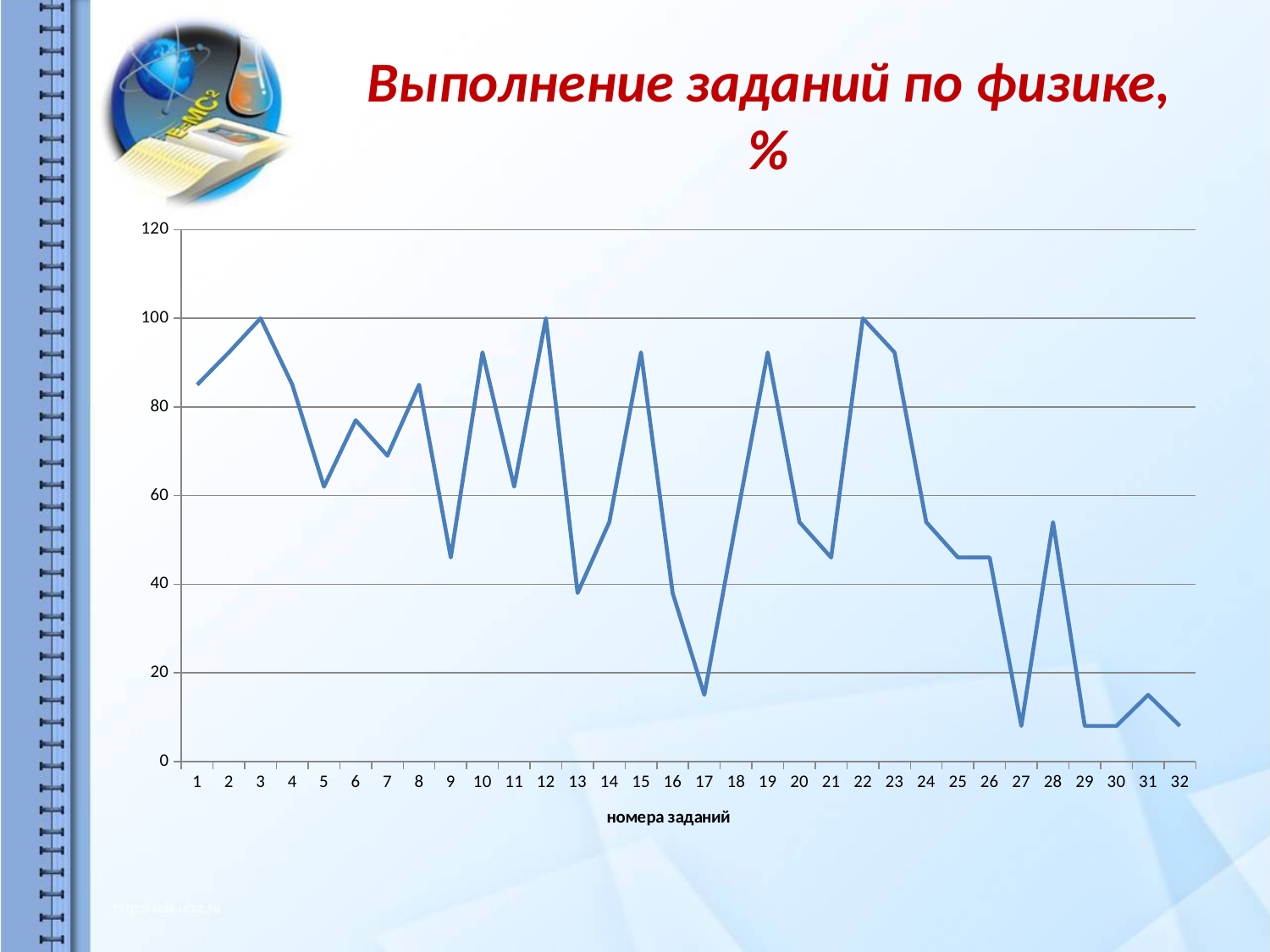
What is the value for task 12? 100 What is the label of the x axis? номера заданий What is the value for task 3? 100 Overall, do the values rise or fall from task 1 to task 32? fall Which has the larger value, task 12 or task 13? task 12 Is the value for task 9 greater or less than 40? greater How many task numbers are plotted along the x axis? 32 Is the value for task 28 greater or less than 60? less Is the value for task 17 greater or less than 20? less What kind of chart is shown on the slide? line chart What is the value for task 22? 100